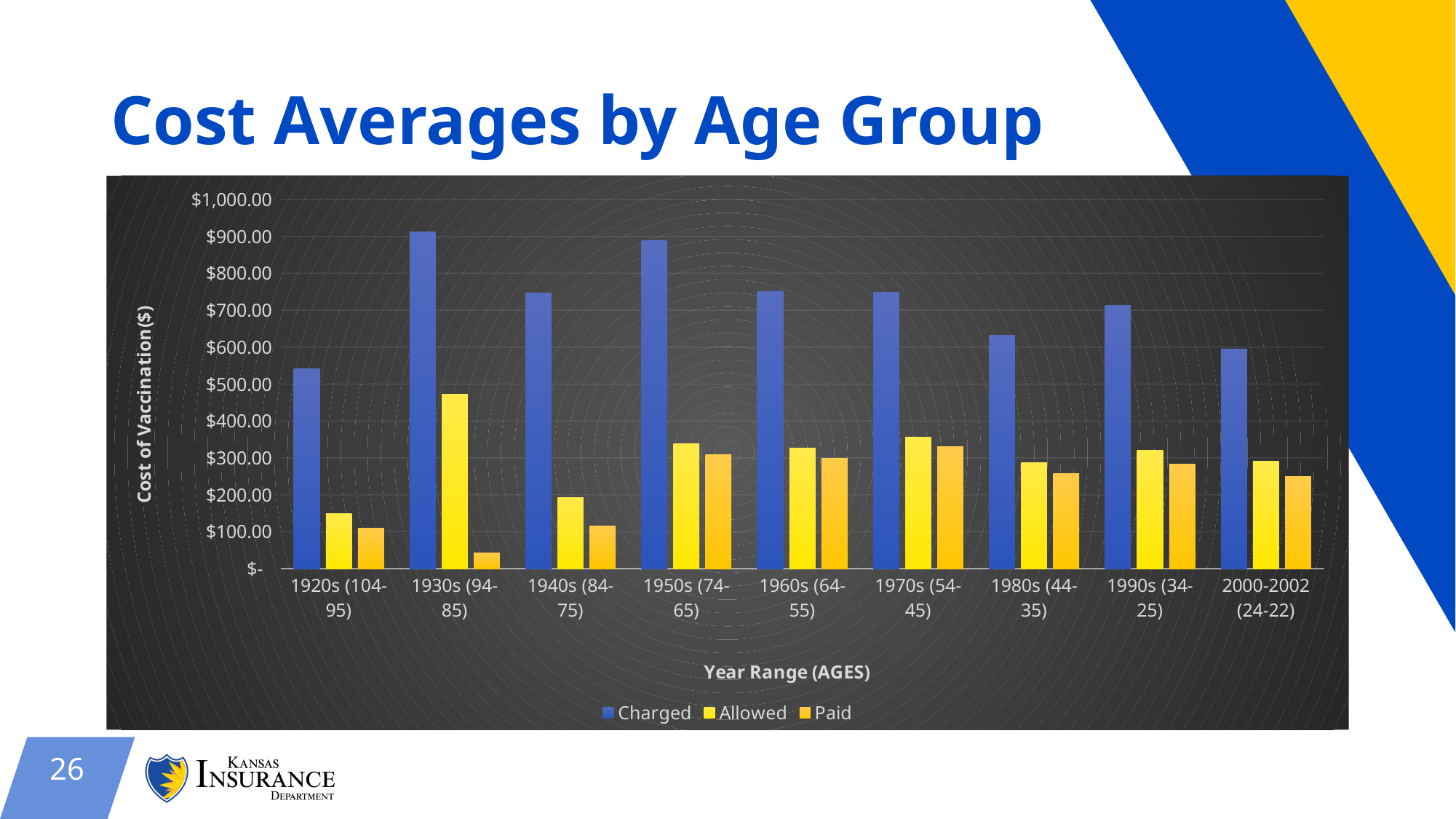
Which age group has the lowest Paid value? 1930s (94-85) Is the Charged value for 1930s (94-85) greater or less than $900.00? greater What is the title of the y axis? Cost of Vaccination($) Is the Allowed value for 1920s (104-95) greater or less than $200.00? less How many age-group categories are shown on the x axis? 9 What kind of chart is shown on the slide? bar chart Which age group has the highest Charged value? 1930s (94-85) Is the Paid value for 1930s (94-85) greater or less than $100.00? less Which age group has the lowest Charged value? 1920s (104-95) How many series does the legend list? 3 Which age group has the highest Allowed value? 1930s (94-85) Which is larger for 1940s (84-75): the Charged value or the Allowed value? Charged